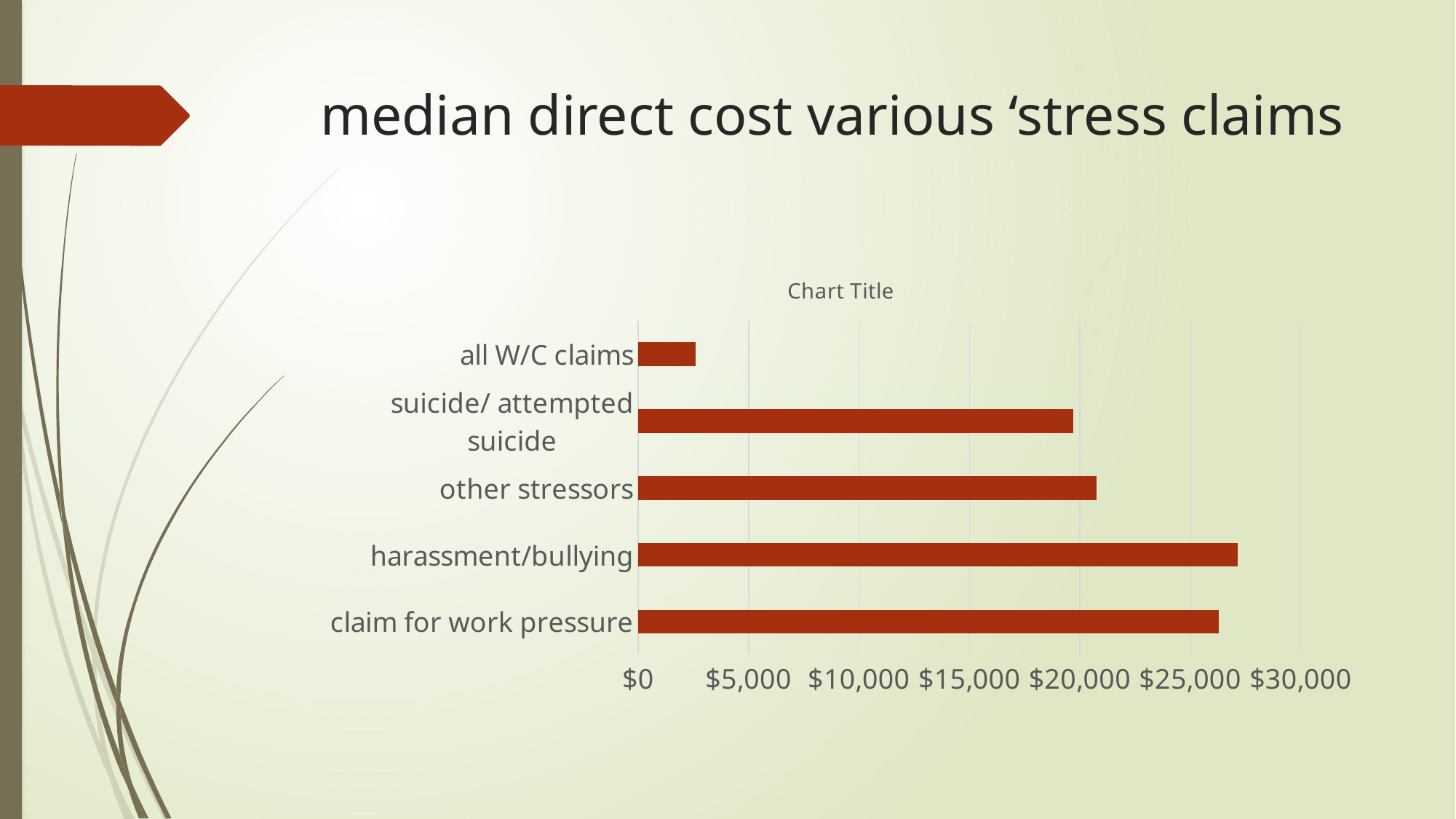
Which is larger, the value for other stressors or the value for all W/C claims? other stressors Is the value for claim for work pressure greater or less than $25,000? greater Is the value for suicide/ attempted suicide greater or less than $15,000? greater Is the value for other stressors greater or less than $15,000? greater Which category has the lowest median direct cost in the chart? all W/C claims What kind of chart is shown on the slide? bar chart What is the title printed above the chart? Chart Title Which is larger, the value for harassment/bullying or the value for all W/C claims? harassment/bullying How many categories are plotted in the chart? 5 What is the highest value shown on the horizontal axis of the chart? $30,000